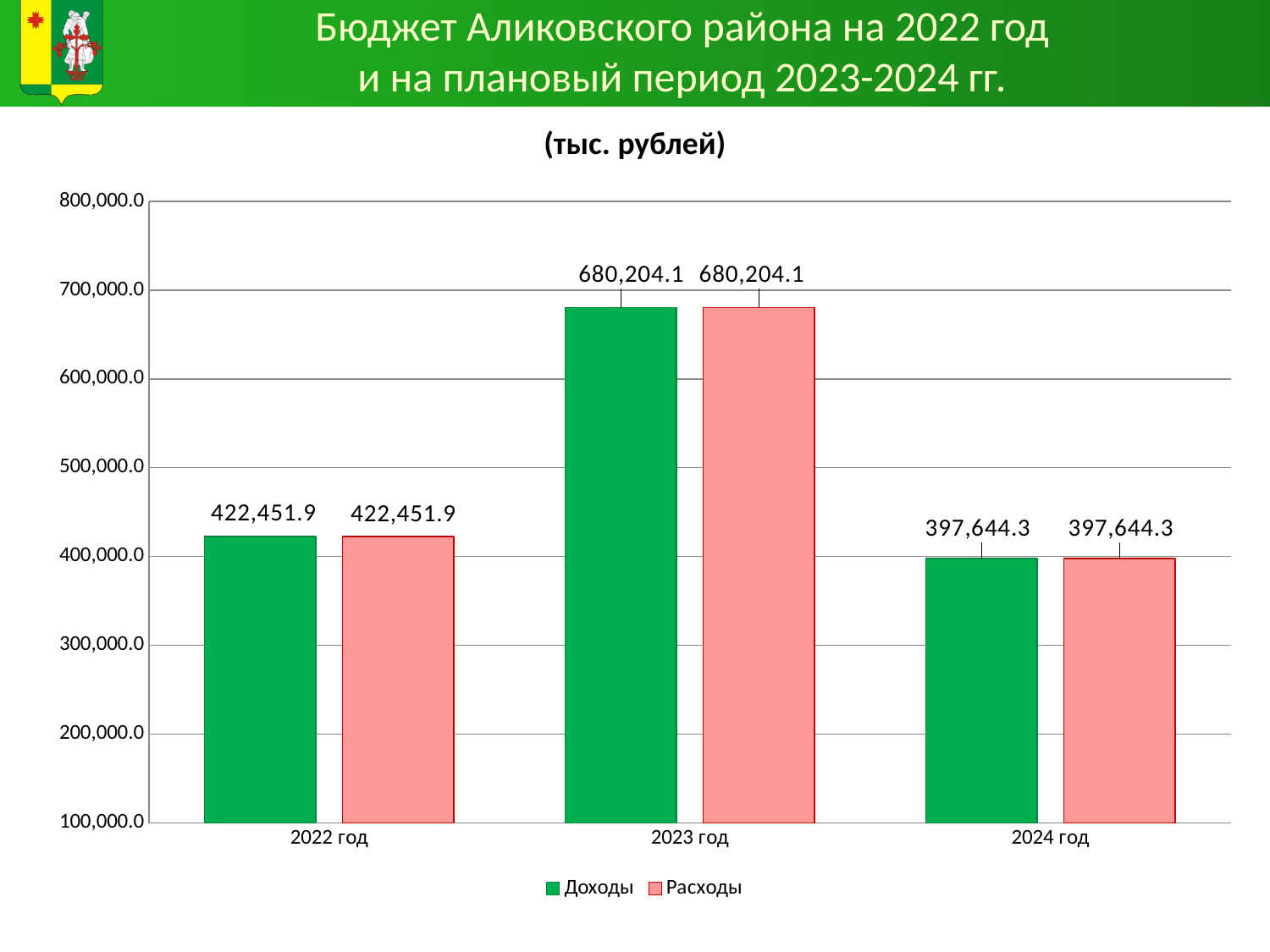
What kind of chart is shown on the slide? bar chart In which year is Доходы the highest? 2023 год How many series does the legend list? 2 What is the difference between Расходы in 2022 год and Расходы in 2024 год? 24,807.6 Which is larger: Доходы in 2022 год or Доходы in 2024 год? 2022 год Is the value of Расходы for 2023 год greater or less than 600,000.0? greater What is the difference between Доходы in 2023 год and Доходы in 2022 год? 257,752.2 How many years (categories) are shown on the x axis? 3 What is the value of Расходы for 2023 год? 680,204.1 What is the value of Доходы for 2024 год? 397,644.3 In which year is Расходы the lowest? 2024 год What is the value of Доходы for 2022 год? 422,451.9